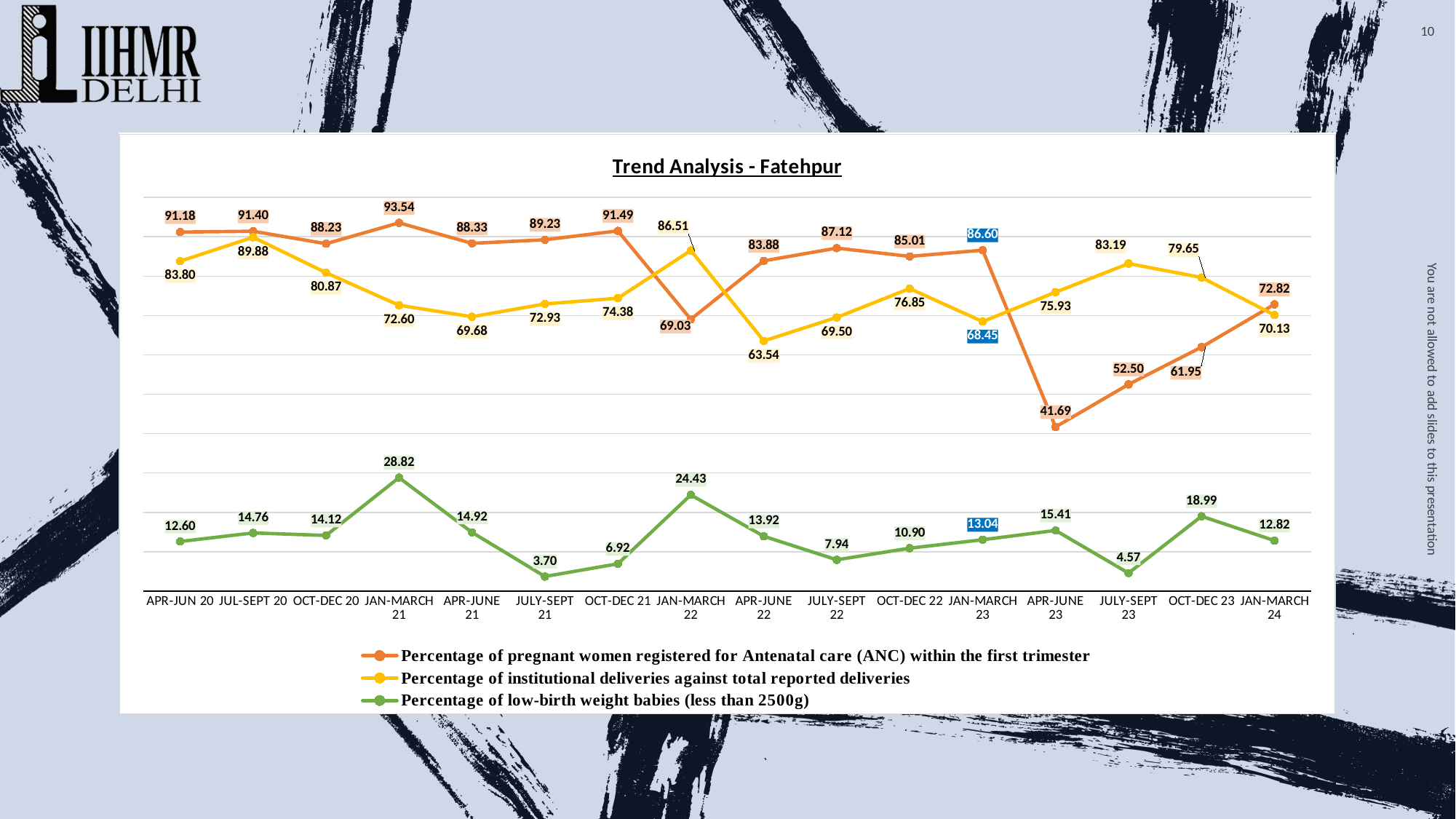
What is the percentage of pregnant women registered for ANC within the first trimester in JAN-MARCH 21? 93.54 How many series does the legend list? 3 How many time periods are shown on the x axis? 16 What kind of chart is shown on the slide? Line chart What is the percentage of low-birth weight babies in OCT-DEC 23? 18.99 In which period is the percentage of institutional deliveries against total reported deliveries highest? JUL-SEPT 20 What is the difference between the percentage of low-birth weight babies in JAN-MARCH 21 and in JULY-SEPT 21? 25.12 What is the percentage of institutional deliveries against total reported deliveries in APR-JUNE 22? 63.54 What is the difference between the highest (JAN-MARCH 21) and lowest (APR-JUNE 23) values of the percentage of pregnant women registered for ANC within the first trimester? 51.85 In which period is the percentage of pregnant women registered for ANC within the first trimester lowest? APR-JUNE 23 In APR-JUNE 23, which is larger: the percentage of pregnant women registered for ANC within the first trimester or the percentage of institutional deliveries? Percentage of institutional deliveries In which period is the percentage of low-birth weight babies highest? JAN-MARCH 21